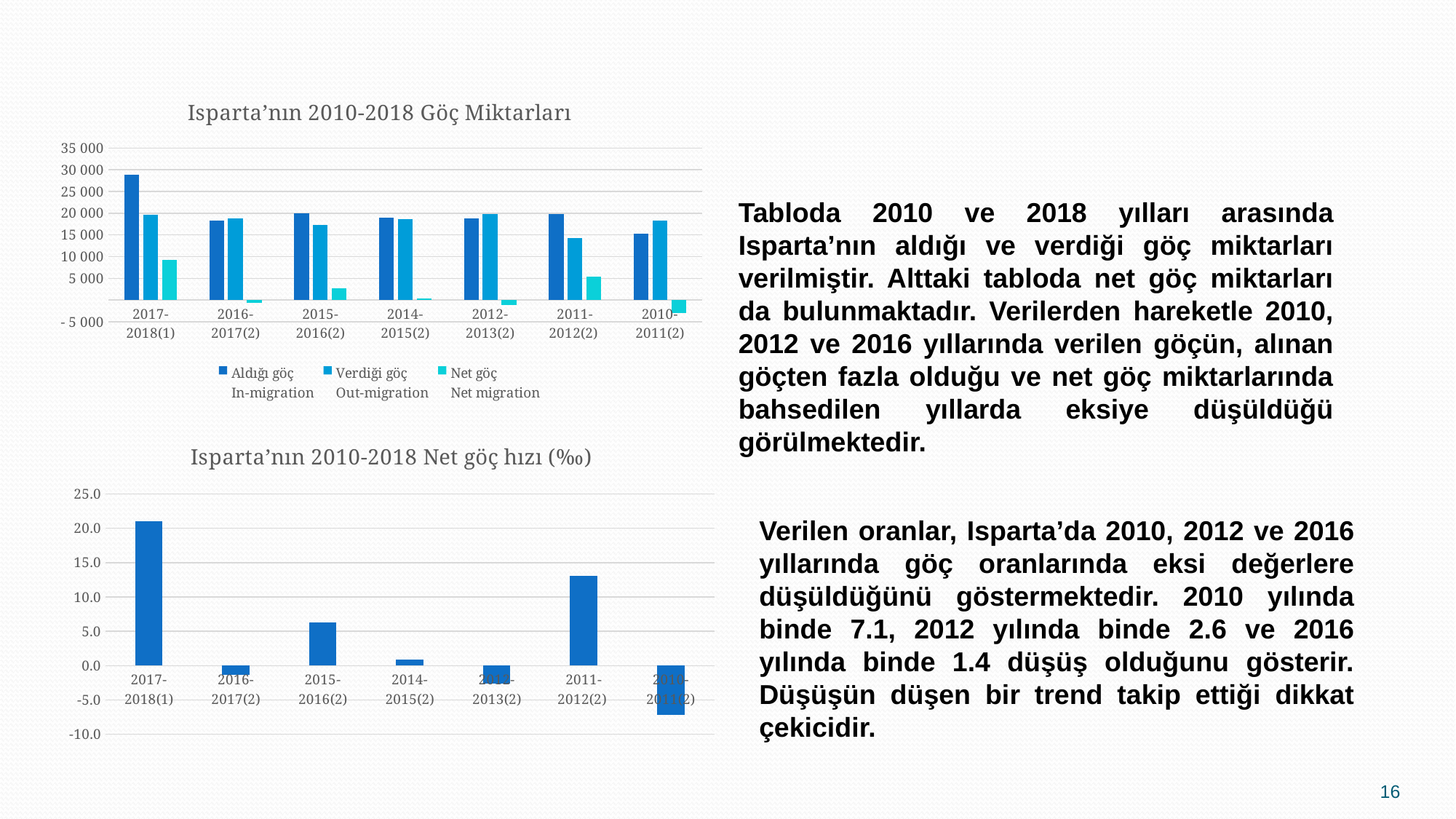
In the bottom chart (Net göç hızı), which category has the lowest value? 2010-2011(2) In the top chart (Göç Miktarları), which is larger for 2010-2011(2): Aldığı göç (In-migration) or Verdiği göç (Out-migration)? Verdiği göç (Out-migration) In the bottom chart (Net göç hızı), which category has the highest value? 2017-2018(1) What is the title of the bottom chart on the slide? Isparta'nın 2010-2018 Net göç hızı (‰) In the bottom chart (Net göç hızı), is the value for 2017-2018(1) greater or less than 20.0? greater In the top chart (Göç Miktarları), is the Aldığı göç (In-migration) value for 2017-2018(1) greater or less than 25 000? greater In the bottom chart (Net göç hızı), is the value for 2011-2012(2) greater or less than 10.0? greater In the top chart (Göç Miktarları), which category has the highest Aldığı göç (In-migration) bar? 2017-2018(1) How many year categories are shown on the x axis of the bottom chart (Net göç hızı)? 7 How many series does the legend of the top chart (Göç Miktarları) list? 3 In the top chart (Göç Miktarları), which is larger for 2011-2012(2): Aldığı göç (In-migration) or Verdiği göç (Out-migration)? Aldığı göç (In-migration) What kind of chart is the top chart titled "Isparta'nın 2010-2018 Göç Miktarları"? Bar chart